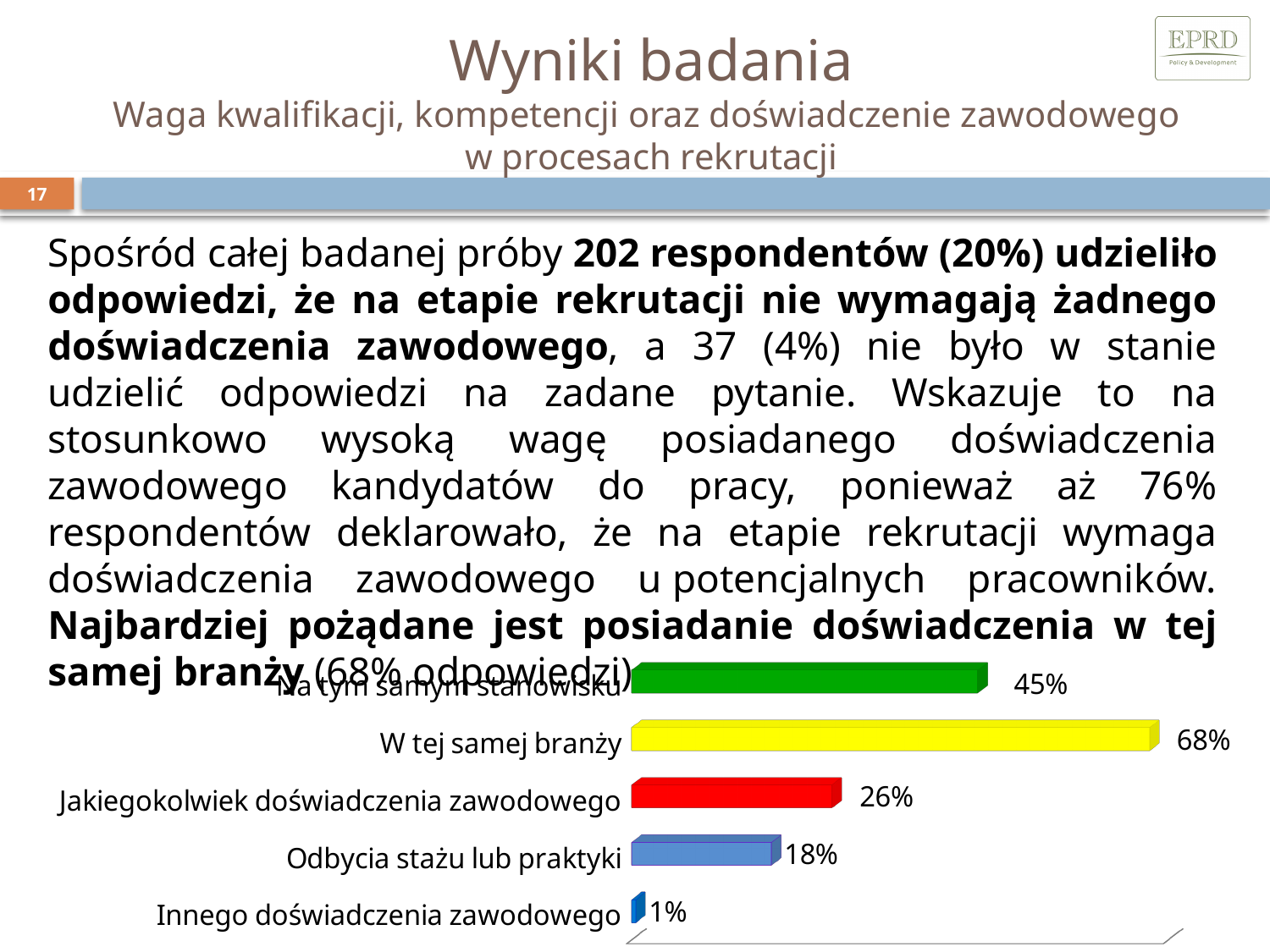
What colour is the bar for "W tej samej branży"? yellow What type of chart is shown on the slide? bar chart What is the difference between the values for "Odbycia stażu lub praktyki" and "Innego doświadczenia zawodowego"? 17% Which is larger: the value for "Odbycia stażu lub praktyki" or "Jakiegokolwiek doświadczenia zawodowego"? Jakiegokolwiek doświadczenia zawodowego Which category has the highest value? W tej samej branży What is the value for "Odbycia stażu lub praktyki"? 18% What is the value for "Jakiegokolwiek doświadczenia zawodowego"? 26% What is the difference between the values for "W tej samej branży" and "Jakiegokolwiek doświadczenia zawodowego"? 42% What is the value for "Innego doświadczenia zawodowego"? 1% What is the value for "W tej samej branży"? 68% Which category has the lowest value? Innego doświadczenia zawodowego How many categories are shown in the chart? 5